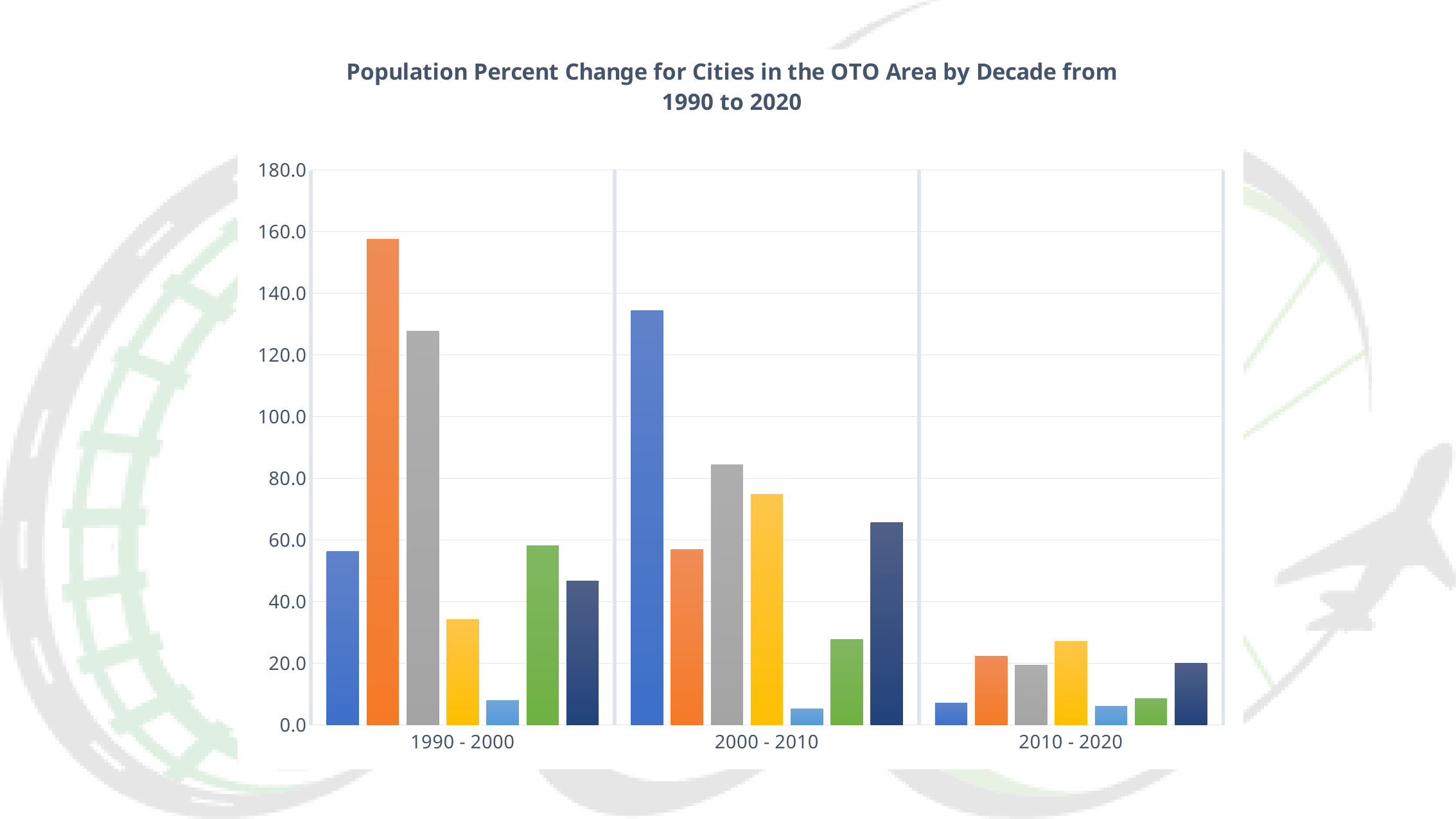
In the 2010 - 2020 group, is the yellow bar or the green bar larger? yellow Is the value of the orange bar in the 1990 - 2000 group greater or less than 140.0? greater Do the orange bars rise or fall across the decades from 1990 - 2000 to 2010 - 2020? fall Is the value of the grey bar in the 1990 - 2000 group greater or less than 100.0? greater What kind of chart is shown on the slide? bar chart How many bars are plotted in each decade group? 7 Is the value of the dark blue (first) bar in the 2000 - 2010 group greater or less than 120.0? greater Which coloured bar is the tallest in the 2000 - 2010 group? blue (first bar) What is the title of the chart? Population Percent Change for Cities in the OTO Area by Decade from 1990 to 2020 How many decade categories are shown on the x axis? 3 Which coloured bar is the shortest in the 1990 - 2000 group? light blue Which coloured bar is the tallest in the 1990 - 2000 group? orange